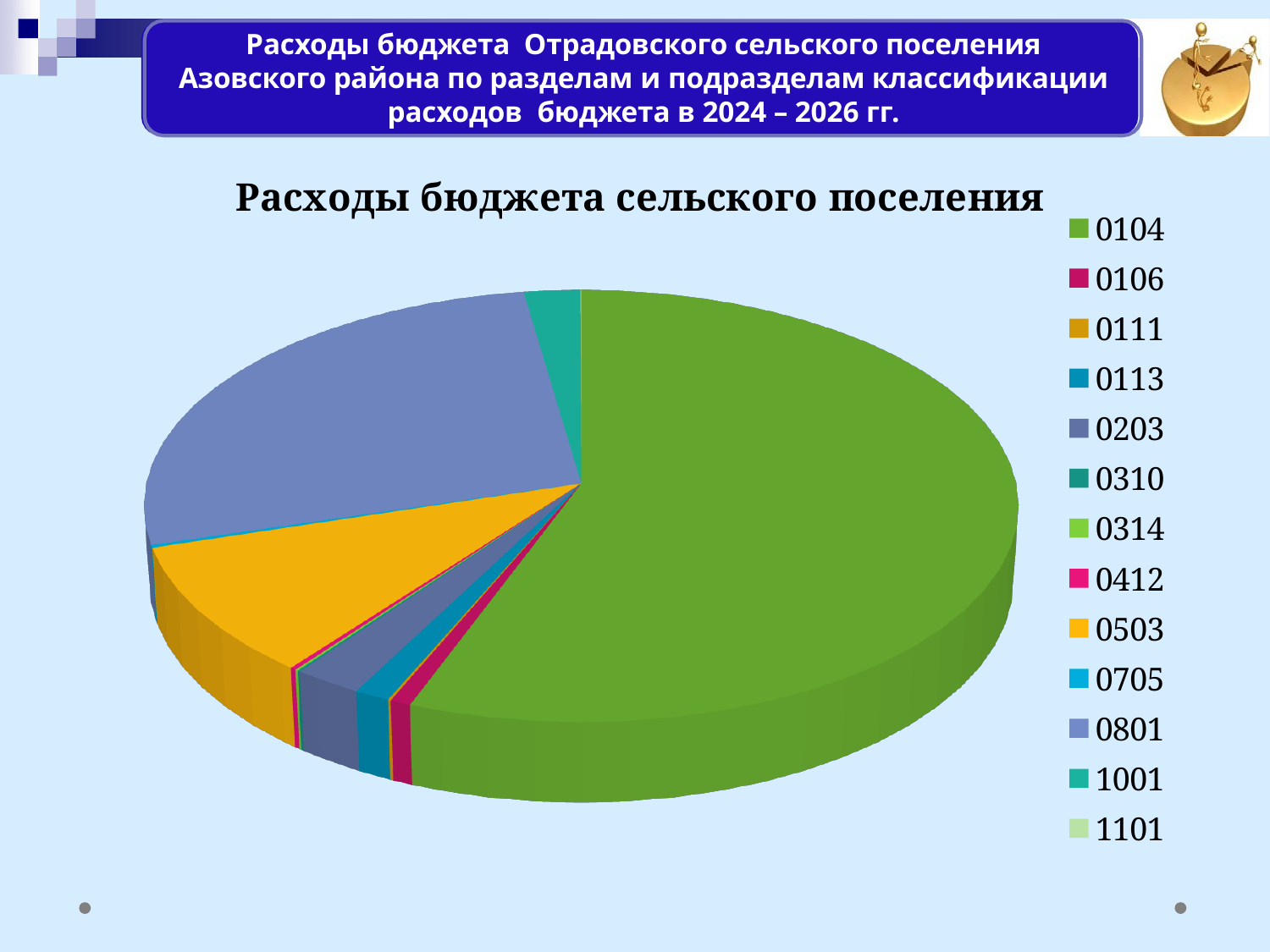
How many categories does the chart legend list? 13 Which category is shown in green in the chart? 0104 Which slice is larger, 0801 or 0503? 0801 What is the title of the chart? Расходы бюджета сельского поселения Which slice is larger, 0104 or 0801? 0104 Which category has the largest slice of the pie? 0104 Which slice is larger, 0503 or 1001? 0503 What kind of chart is shown on the slide? pie chart